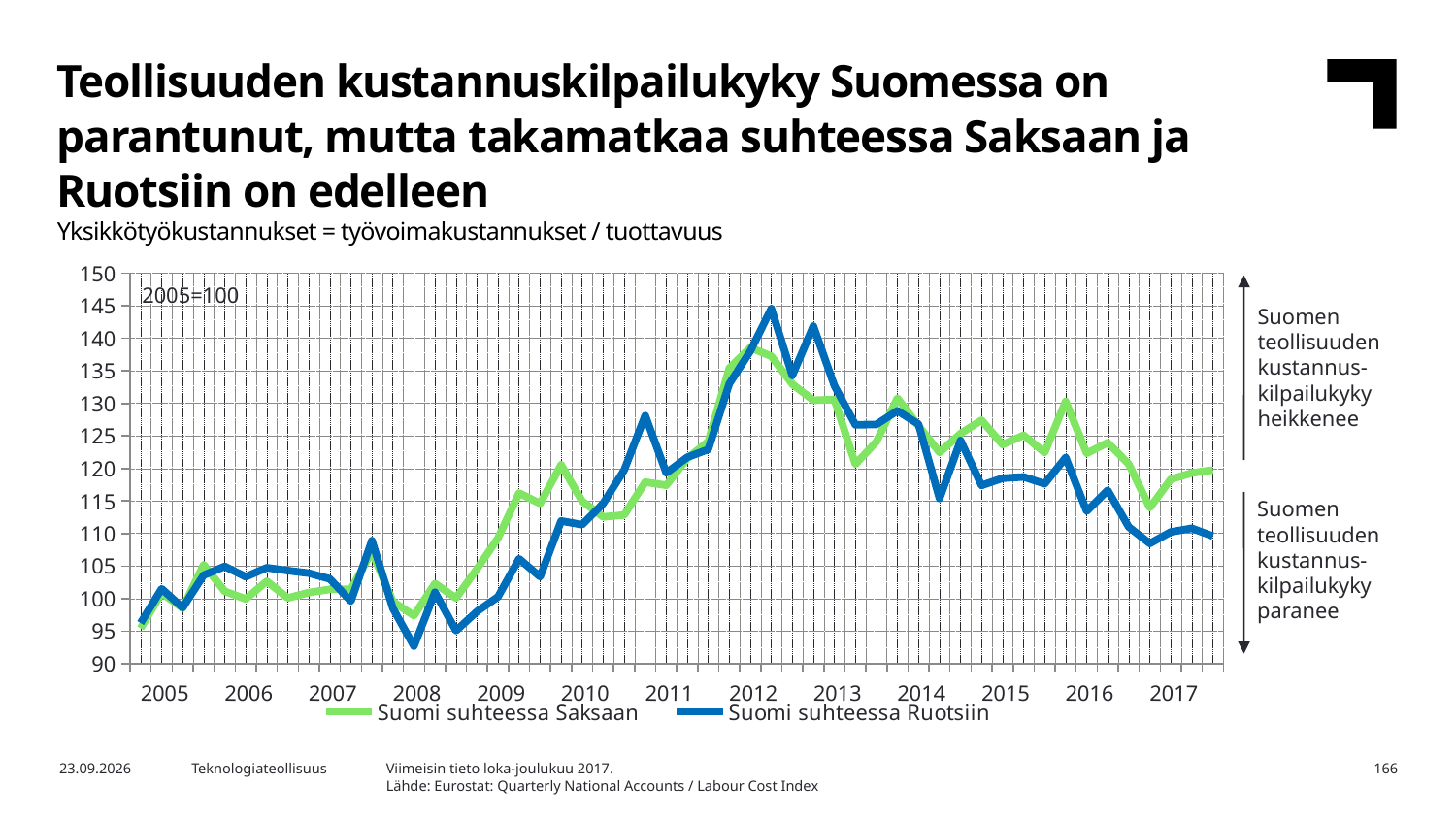
Do both series rise or fall between their 2012 peaks and the end of 2017? fall How many series does the legend list? 2 What base year and index value is noted inside the chart? 2005=100 At the end of 2017, which series is higher: Suomi suhteessa Saksaan or Suomi suhteessa Ruotsiin? Suomi suhteessa Saksaan How many years are labelled on the x axis? 13 What are the two series named in the legend? Suomi suhteessa Saksaan; Suomi suhteessa Ruotsiin Is the peak value of the Suomi suhteessa Ruotsiin series in 2012 greater or less than 140? greater Is the peak value of the Suomi suhteessa Saksaan series in 2012 greater or less than 135? greater Is the value of the Suomi suhteessa Saksaan series at the end of 2017 greater or less than 115? greater What kind of chart is shown on the slide? line chart